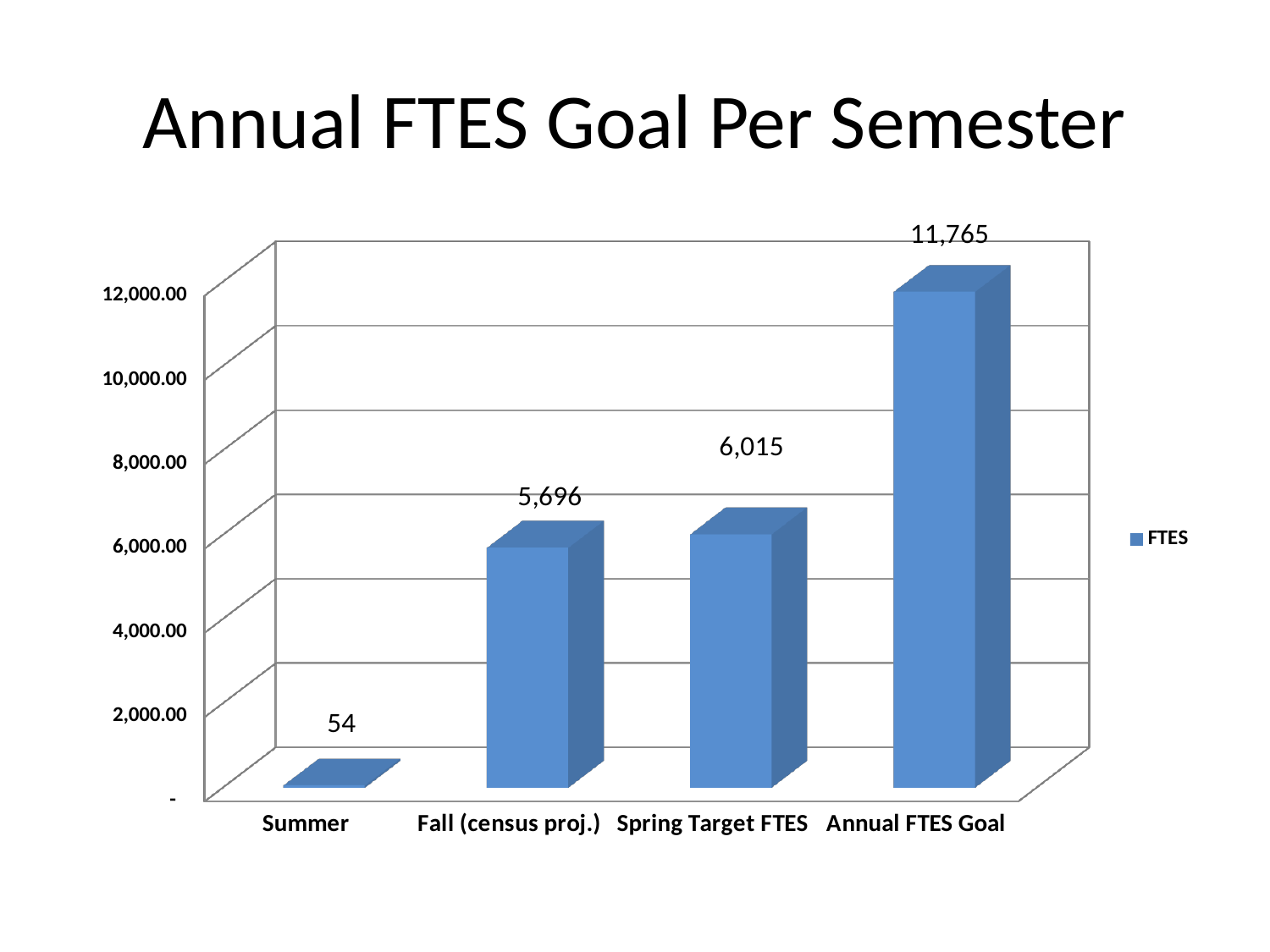
Which category has the lowest value? Summer How many categories are shown on the x axis? 4 What is the FTES value for Summer? 54 What kind of chart is shown on the slide? Bar chart What is the value for Annual FTES Goal? 11,765 What is the difference between the Spring Target FTES and Fall (census proj.) values? 319 Which category has the highest value? Annual FTES Goal Which is larger, the value for Fall (census proj.) or Spring Target FTES? Spring Target FTES What is the FTES value for Spring Target FTES? 6,015 What is the FTES value for Fall (census proj.)? 5,696 How many series does the legend list? 1 Is the value for Annual FTES Goal greater or less than 10,000.00? greater